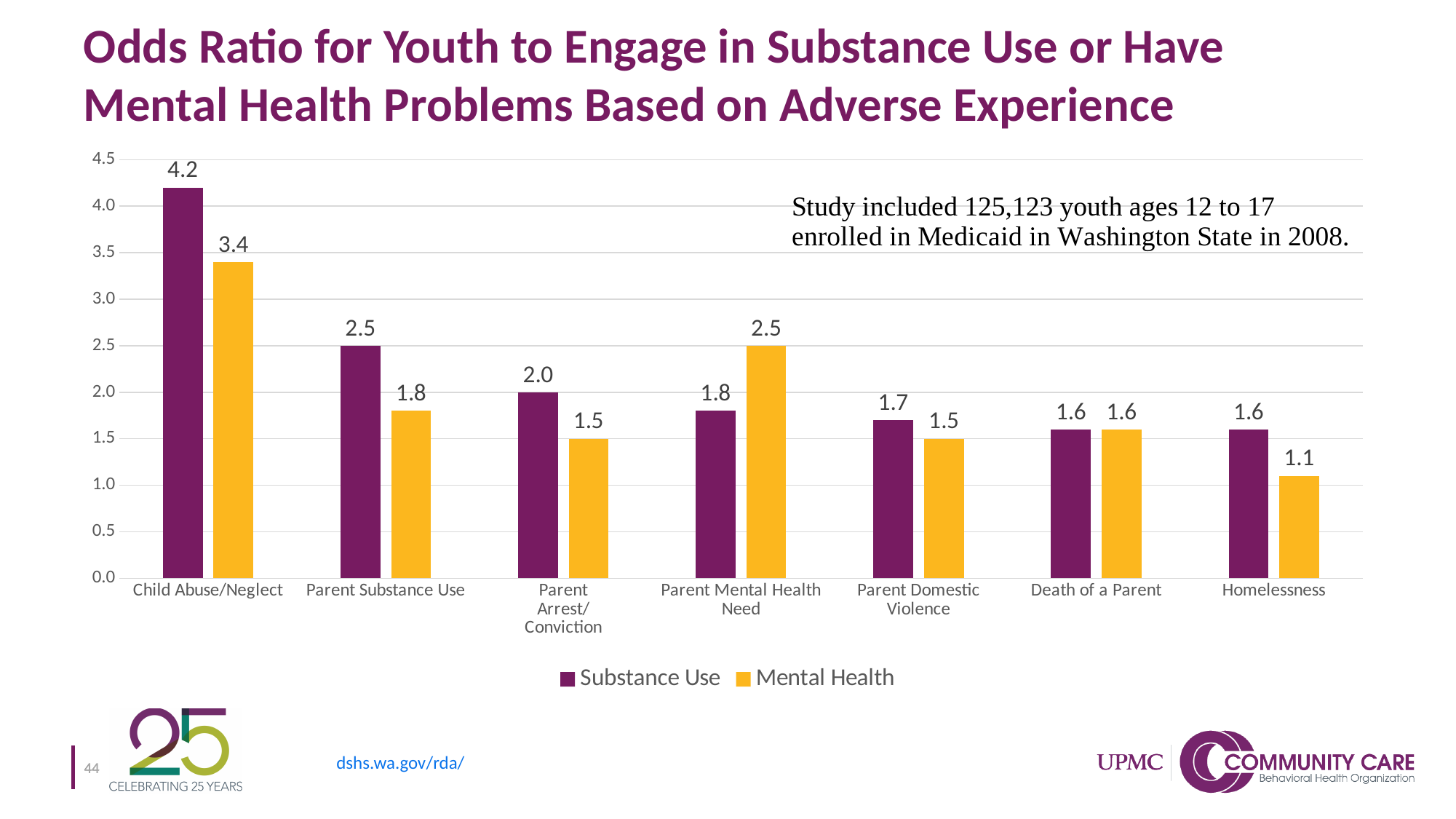
For Parent Mental Health Need, which is larger: the Substance Use or the Mental Health odds ratio? Mental Health Which colour represents the Mental Health series in the chart? Yellow What is the Mental Health odds ratio for Parent Mental Health Need? 2.5 Which adverse experience has the lowest Mental Health odds ratio? Homelessness What kind of chart is shown on the slide? Bar chart What is the Substance Use odds ratio for Child Abuse/Neglect? 4.2 How many adverse experience categories are shown on the x axis? 7 What is the difference between the Substance Use and Mental Health odds ratios for Child Abuse/Neglect? 0.8 Is the Mental Health odds ratio for Child Abuse/Neglect greater or less than 3.0? greater How many series does the legend list? 2 What is the Mental Health odds ratio for Homelessness? 1.1 Which adverse experience has the highest Substance Use odds ratio? Child Abuse/Neglect